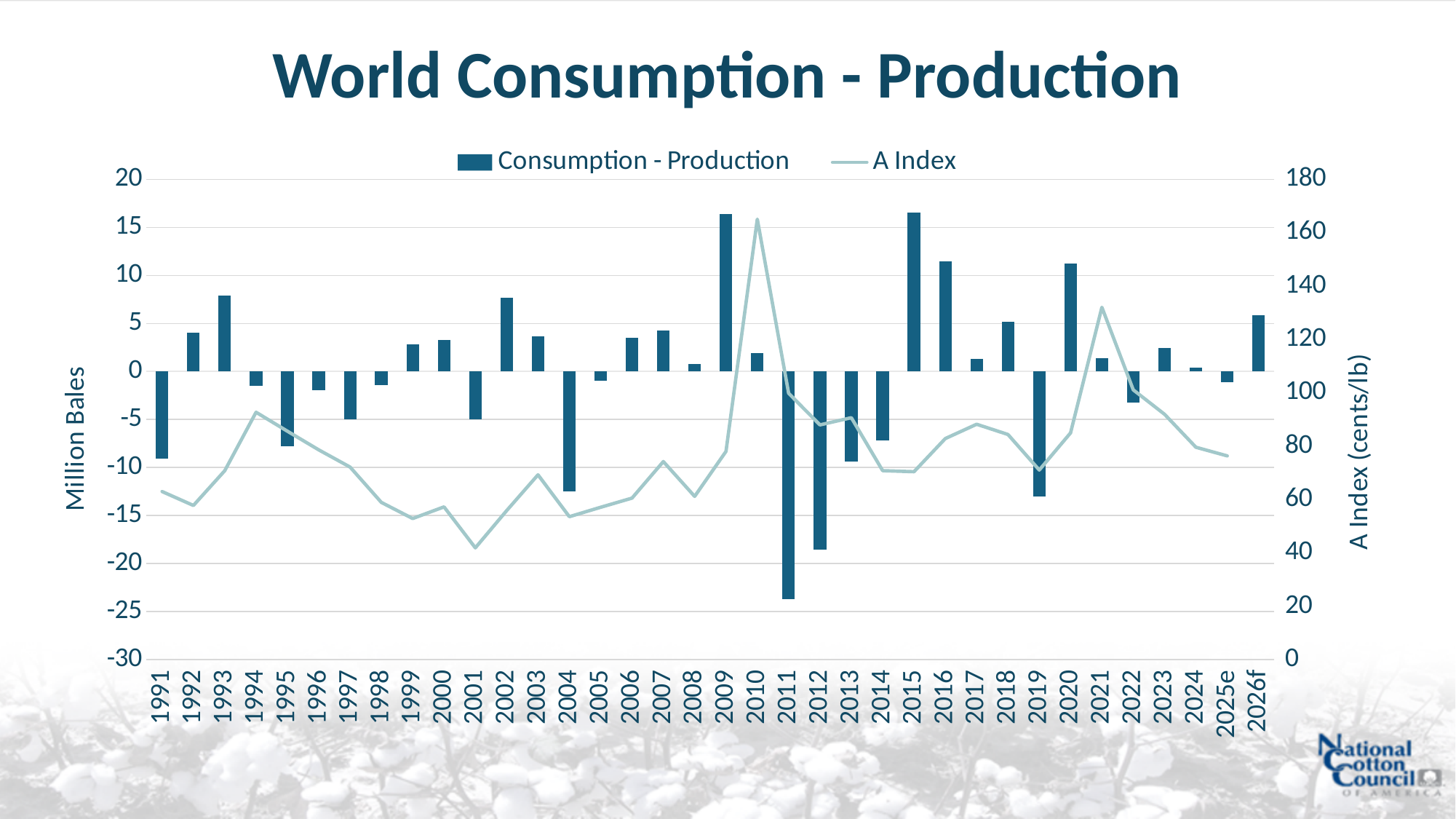
In which year does the A Index line reach its highest point? 2010 What kind of chart is this? Combination bar chart and line chart Is the Consumption - Production value for 2020 greater or less than 10? greater In which year does the A Index line reach its lowest point? 2001 In which year is the Consumption - Production bar lowest? 2011 How many years (categories) are shown on the x axis? 36 Which year has the larger Consumption - Production value, 2011 or 2012? 2012 Is the A Index value for 2010 greater or less than 140? greater How many series does the legend list? 2 Is the Consumption - Production value for 2011 greater or less than -20? less